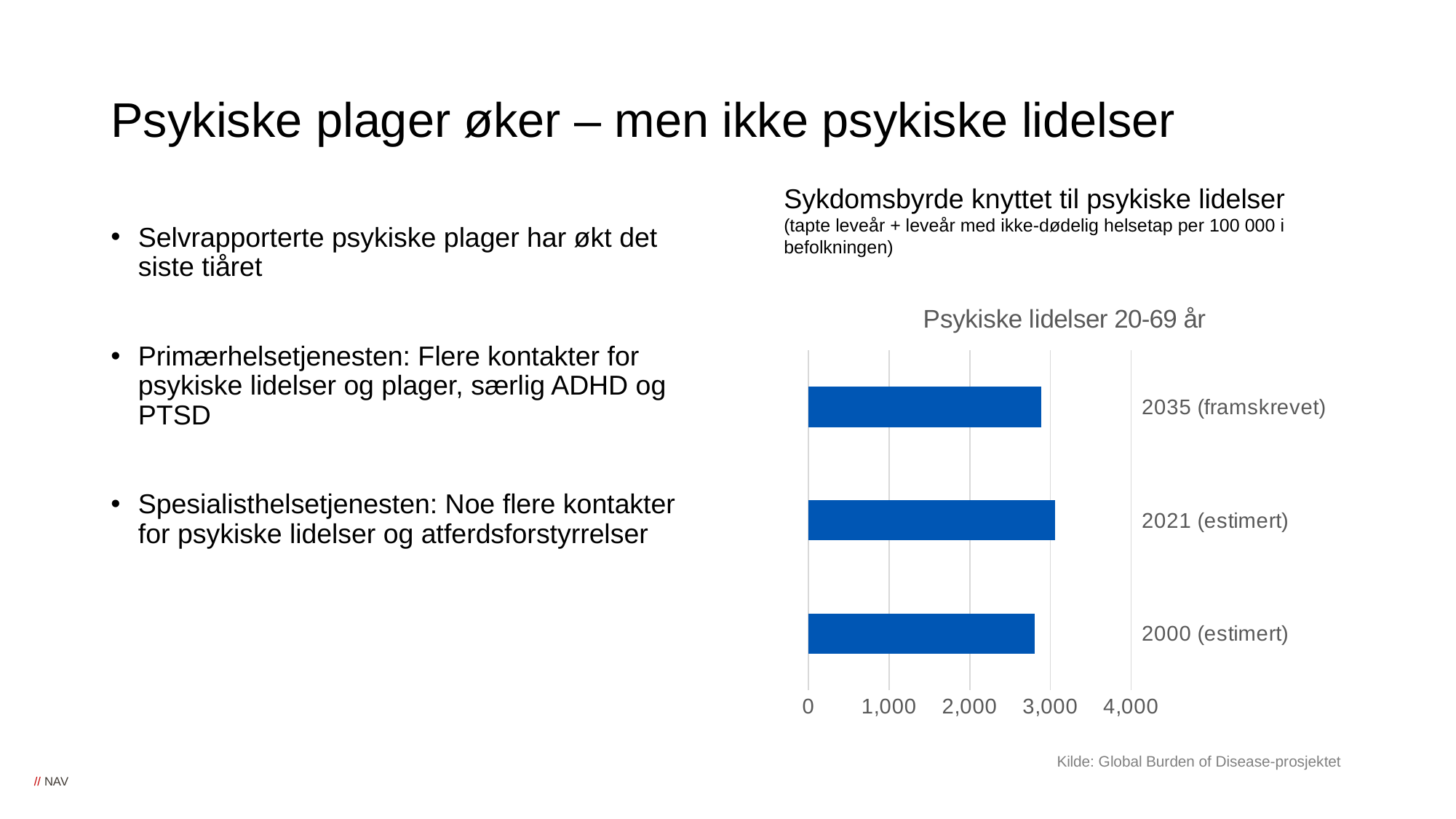
Is the value for 2035 (framskrevet) greater or less than 3,000? less Is the value for 2021 (estimert) greater or less than 3,000? greater Which is larger, the value for 2021 (estimert) or the value for 2000 (estimert)? 2021 (estimert) What is the title of the chart? Psykiske lidelser 20-69 år How many categories (bars) does the chart show? 3 What kind of chart is shown on the slide? bar chart Is the value for 2000 (estimert) greater or less than 3,000? less What is the highest value shown on the chart's horizontal axis? 4,000 Which is larger, the value for 2021 (estimert) or the value for 2035 (framskrevet)? 2021 (estimert) Which category has the highest value in the chart? 2021 (estimert)